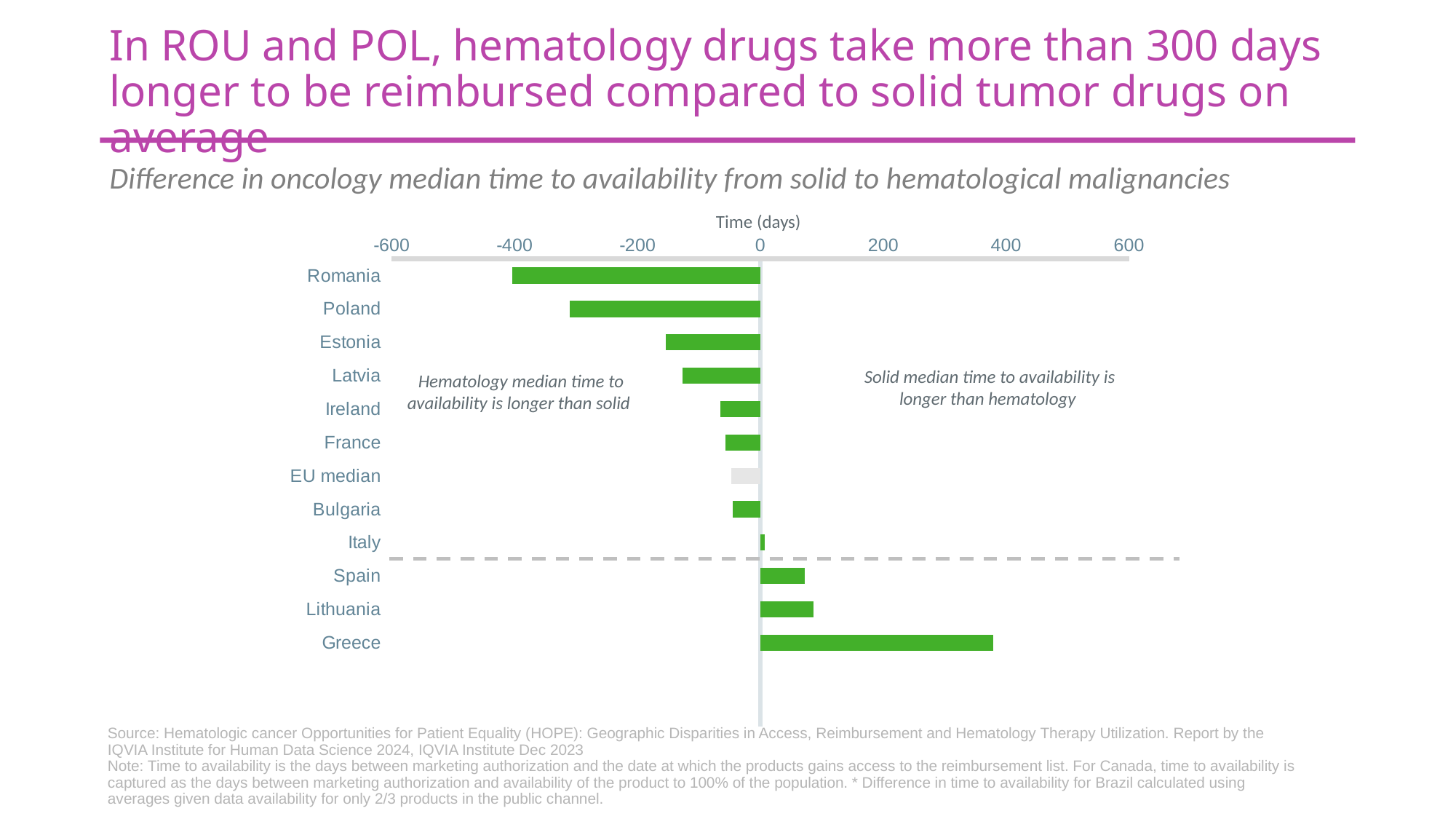
Which category's bar is shown in grey rather than green? EU median How many categories are plotted on the chart? 12 Is the value for Poland greater or less than -200? less Is the value for Estonia greater or less than -200? greater What kind of chart is shown on the slide? bar chart Which has the larger value, Greece or Lithuania? Greece Is the value for Lithuania greater or less than 200? less What is the title of the horizontal axis? Time (days) Which category has the highest (most positive) value? Greece Which category has the lowest (most negative) value? Romania